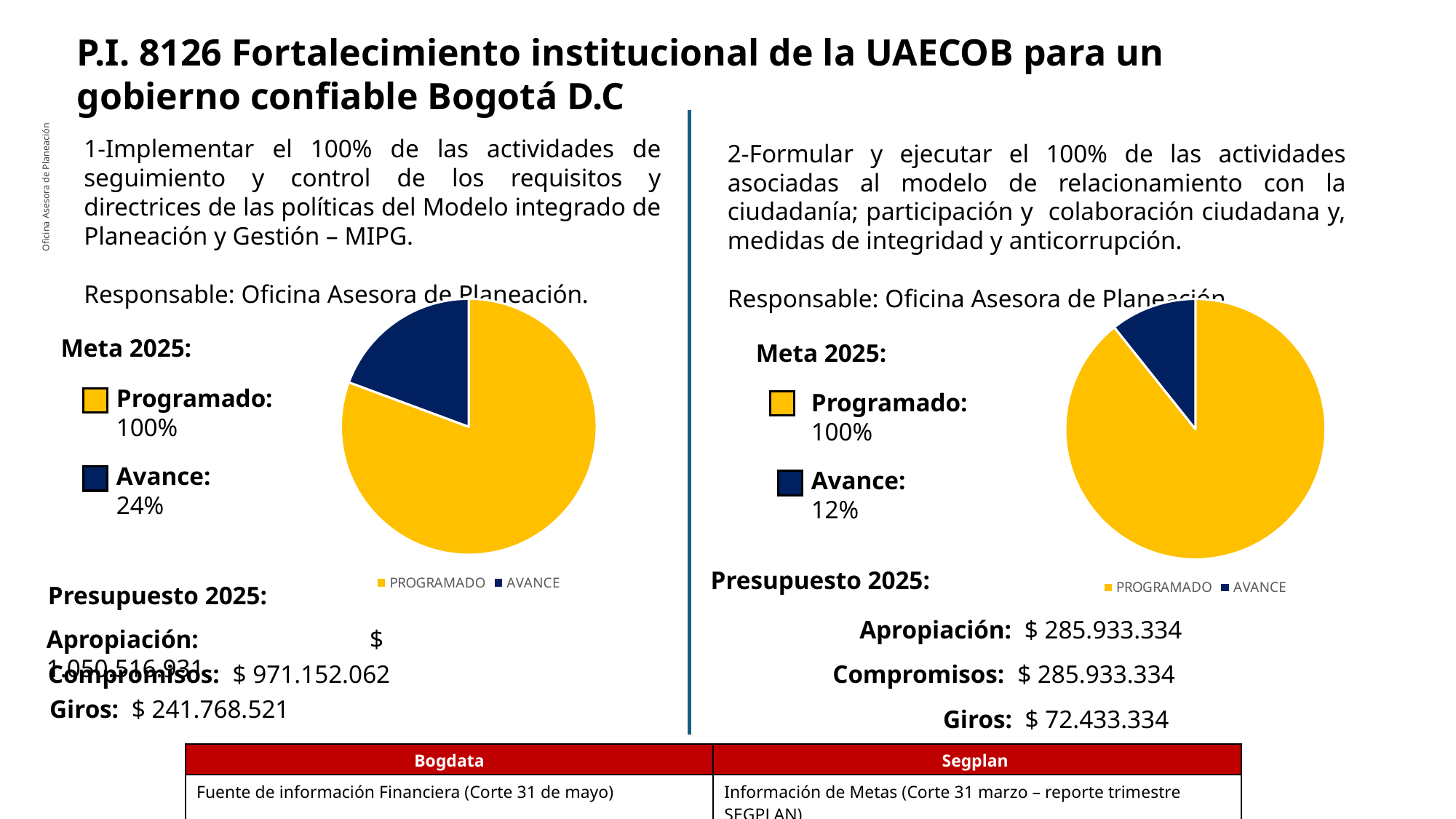
In the left pie chart, which slice is the smallest? AVANCE How many entries does the legend of the left pie chart list? 2 Is the Avance slice larger in the left pie chart or in the right pie chart? left pie chart In the left pie chart, what is the value shown for Programado? 100% In the left pie chart, what is the value shown for Avance? 24% What are the two legend entries of the right pie chart? PROGRAMADO and AVANCE What colour is the AVANCE slice in the left pie chart? dark blue In the right pie chart, which slice is the largest? PROGRAMADO What kind of chart is the left chart on the slide? pie chart What kind of chart is the right chart on the slide? pie chart In the right pie chart, what is the value shown for Avance? 12% How many slices does the right pie chart have? 2